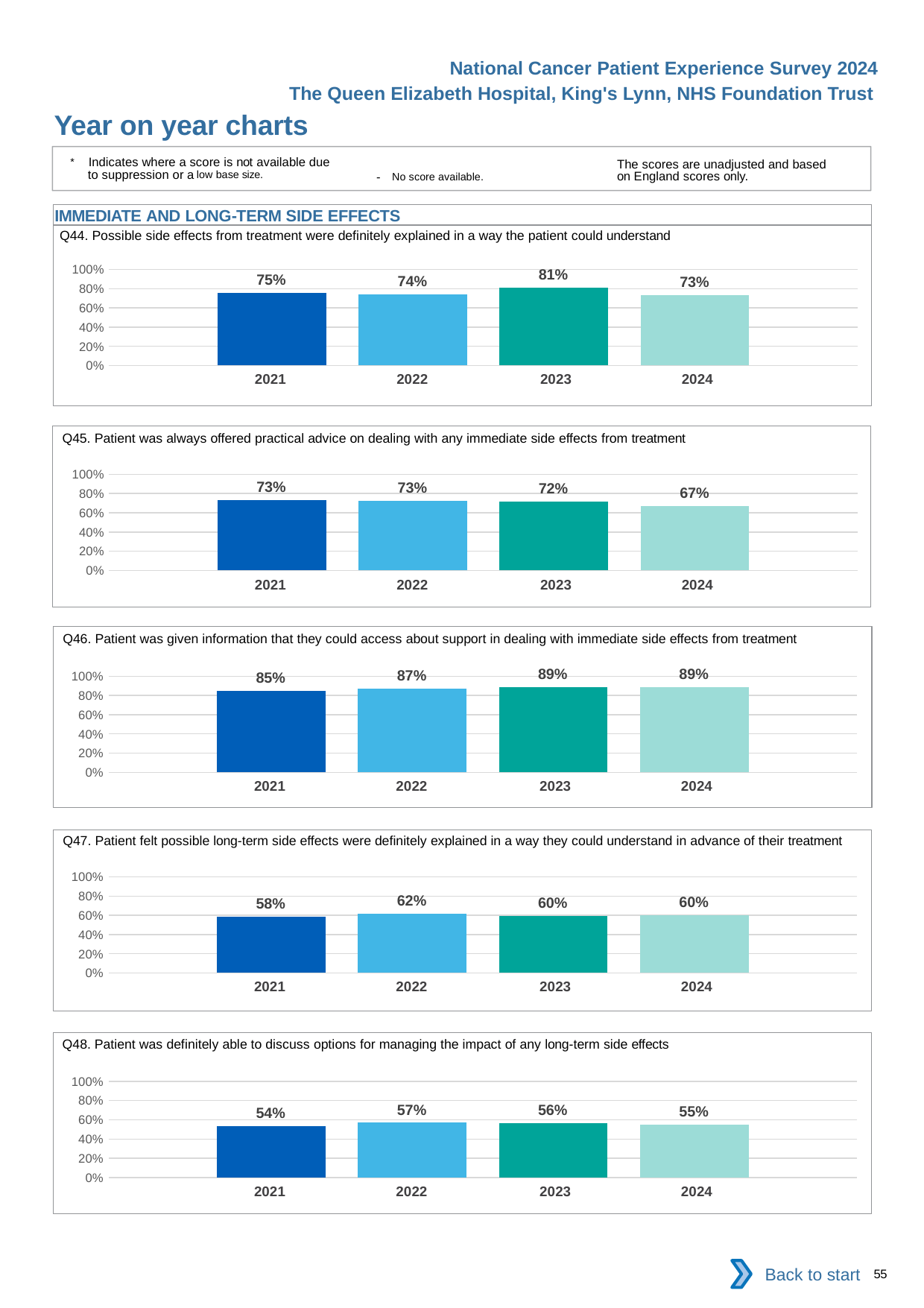
In the Q47 chart, what is the value for 2021? 58% In the Q44 chart, what is the value for 2023? 81% In the Q46 chart, what is the difference between the 2024 value and the 2021 value? 4% What kind of chart is the Q47 chart? Bar chart In the Q45 chart, which year has the lowest value? 2024 In the Q47 chart, which year has the highest value? 2022 In the Q45 chart, what is the difference between the 2021 value and the 2024 value? 6% In the Q44 chart, which is larger, the value for 2021 or the value for 2024? 2021 How many years are shown in the Q46 chart? 4 In the Q46 chart, do the values rise or fall from 2021 to 2023? Rise In the Q48 chart, what is the value for 2021? 54% In the Q48 chart, is the value for 2022 greater or less than 40%? greater